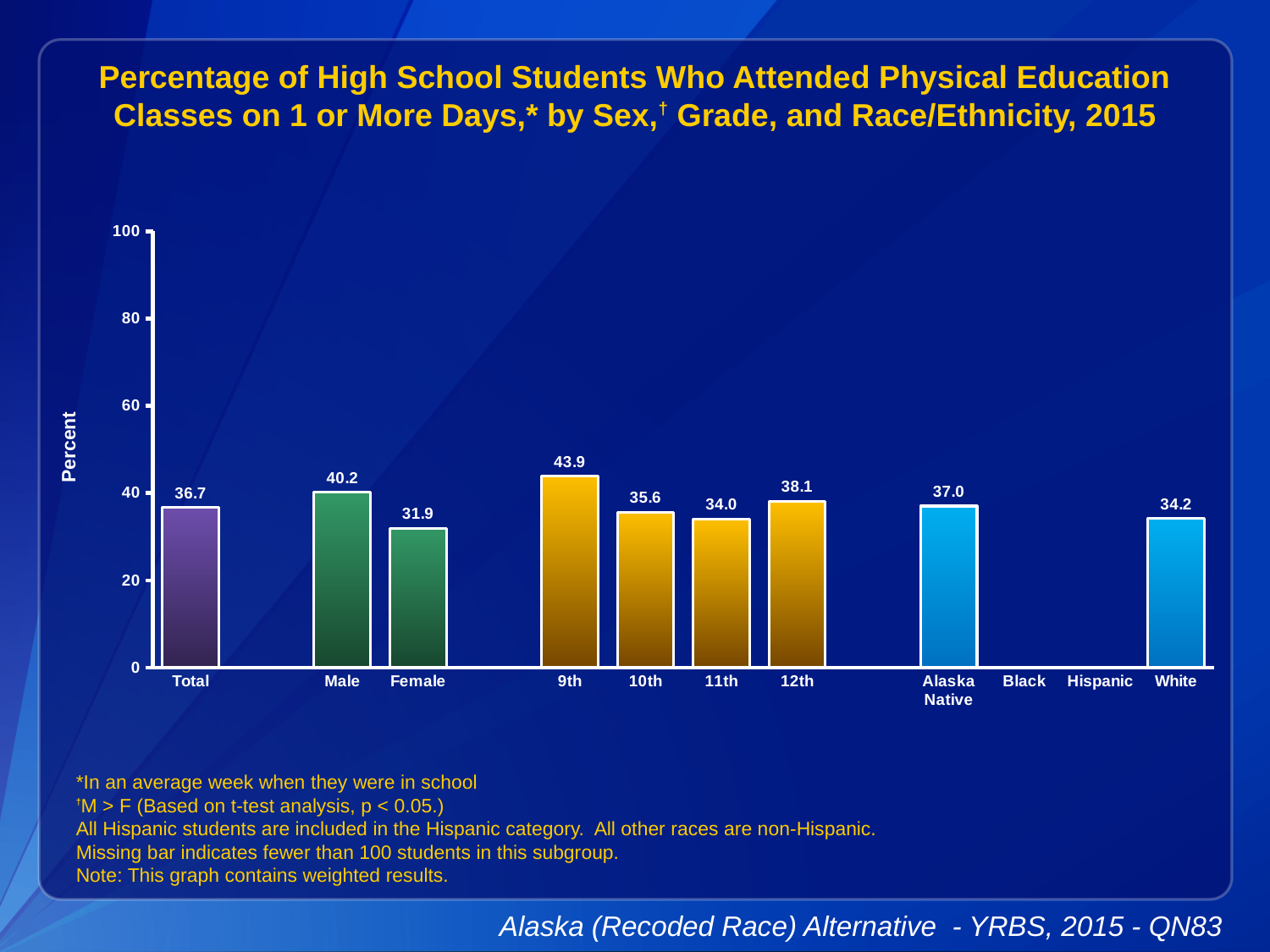
What is the value for Female? 31.9 How many categories are labeled on the x axis? 11 What is the label of the y axis? Percent What is the value for 12th grade? 38.1 What kind of chart is shown? bar chart Which categories on the x axis have no bar? Black and Hispanic What is the difference between the Male and Female values? 8.3 Is the value for 10th grade greater or less than 40? less What is the value for Total? 36.7 Which category with a bar has the lowest value? Female Which is larger, the value for Alaska Native or the value for White? Alaska Native Which category has the highest value? 9th